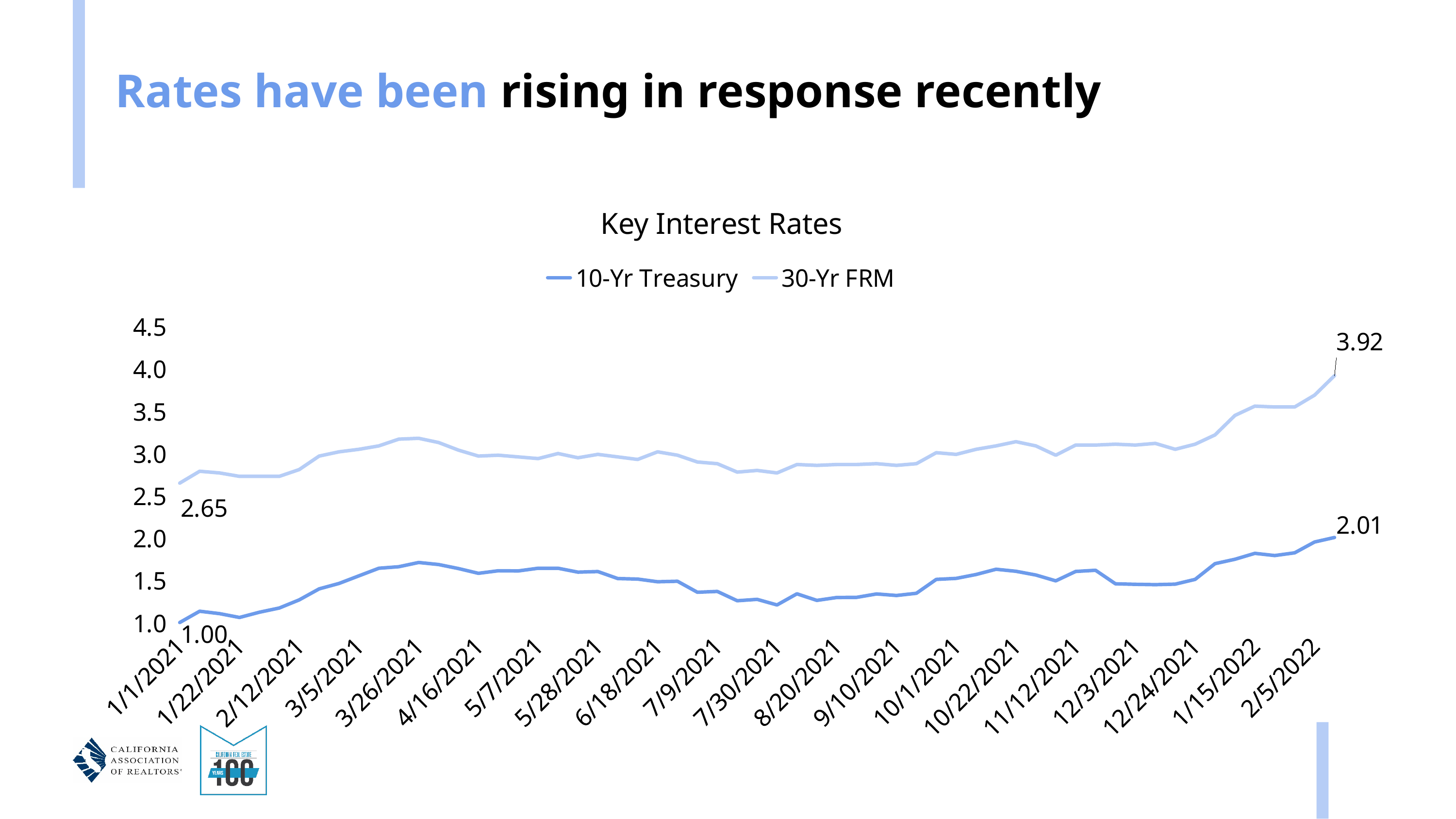
What is the title of the chart? Key Interest Rates How many series does the legend of the Key Interest Rates chart list? 2 By how much did the 10-Yr Treasury rise from its first labeled value to its last labeled value? 1.01 What is the difference between the last labeled values of the 30-Yr FRM and the 10-Yr Treasury? 1.91 Is the 30-Yr FRM value at 3/26/2021 greater or less than 3.0? greater Which series has the higher values throughout the chart, 10-Yr Treasury or 30-Yr FRM? 30-Yr FRM What kind of chart is shown on the slide? line chart What is the first labeled value of the 10-Yr Treasury series? 1.00 What is the first labeled value of the 30-Yr FRM series? 2.65 What is the last labeled value of the 10-Yr Treasury series? 2.01 What is the last labeled value of the 30-Yr FRM series? 3.92 By how much did the 30-Yr FRM rise from its first labeled value to its last labeled value? 1.27